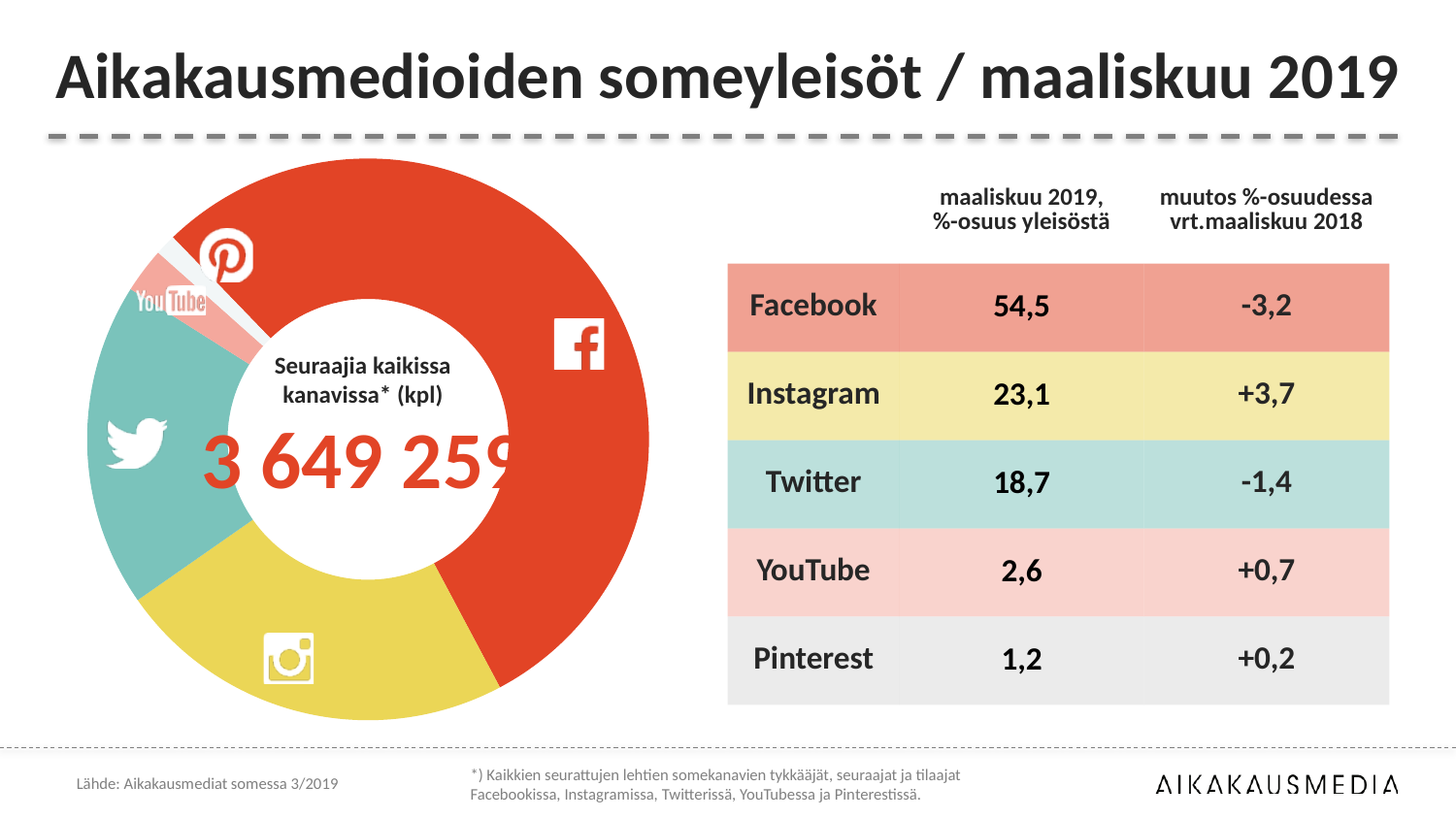
What is Instagram's share of the audience in March 2019? 23,1 What is the change in percentage share for Instagram compared with March 2018? +3,7 Which channel has the smallest share of the audience in the donut chart? Pinterest Which channel has the largest share of the audience in the donut chart? Facebook What is the total number of followers across all channels shown in the centre of the donut chart? 3 649 259 How many social media channels are shown in the donut chart? 5 What is the difference in percentage share between Facebook and Instagram in March 2019? 31,4 Which channel had the largest decrease in percentage share compared with March 2018? Facebook What is the title of the slide? Aikakausmedioiden someyleisöt / maaliskuu 2019 What kind of chart is shown on the left of the slide? donut chart What is Facebook's share of the audience in March 2019 (maaliskuu 2019, %-osuus yleisöstä)? 54,5 Which has a larger share of the audience, Twitter or Instagram? Instagram